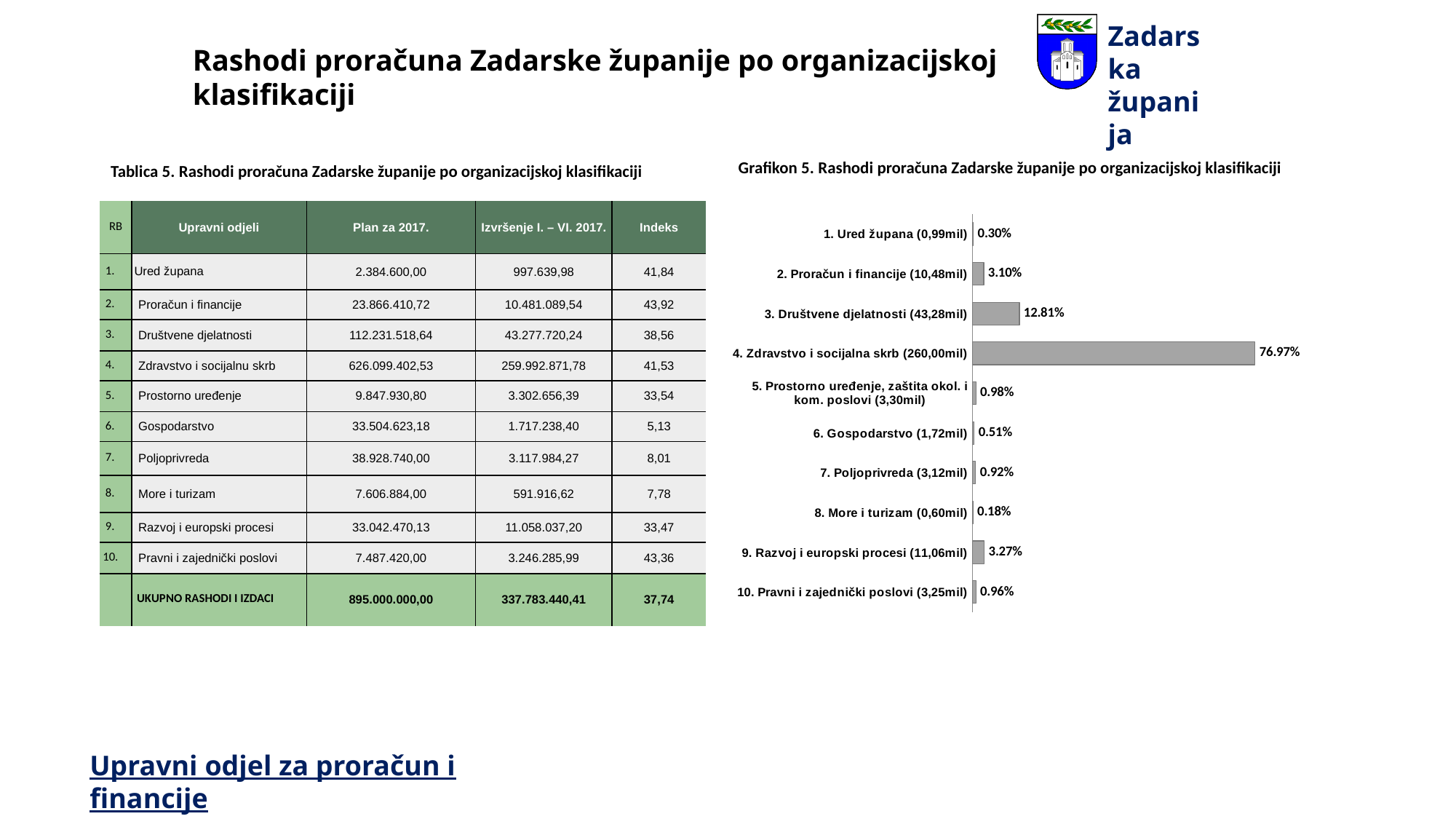
In Grafikon 5, what is the value for 4. Zdravstvo i socijalna skrb (260,00mil)? 76.97% Which category has the lowest value in Grafikon 5? 8. More i turizam (0,60mil) In Grafikon 5, what is the value for 3. Društvene djelatnosti (43,28mil)? 12.81% How many categories are shown in Grafikon 5? 10 In Grafikon 5, which is larger: the value for 7. Poljoprivreda or 6. Gospodarstvo? 7. Poljoprivreda (3,12mil) Which category has the highest value in Grafikon 5? 4. Zdravstvo i socijalna skrb (260,00mil) In Grafikon 5, which is larger: the value for 2. Proračun i financije or 9. Razvoj i europski procesi? 9. Razvoj i europski procesi (11,06mil) In Grafikon 5, what is the value for 8. More i turizam (0,60mil)? 0.18% In Grafikon 5, what is the value for 9. Razvoj i europski procesi (11,06mil)? 3.27% What type of chart is Grafikon 5? bar chart What is the title of the chart on the slide? Grafikon 5. Rashodi proračuna Zadarske županije po organizacijskoj klasifikaciji In Grafikon 5, what is the difference between the values for 4. Zdravstvo i socijalna skrb and 3. Društvene djelatnosti? 64.16%